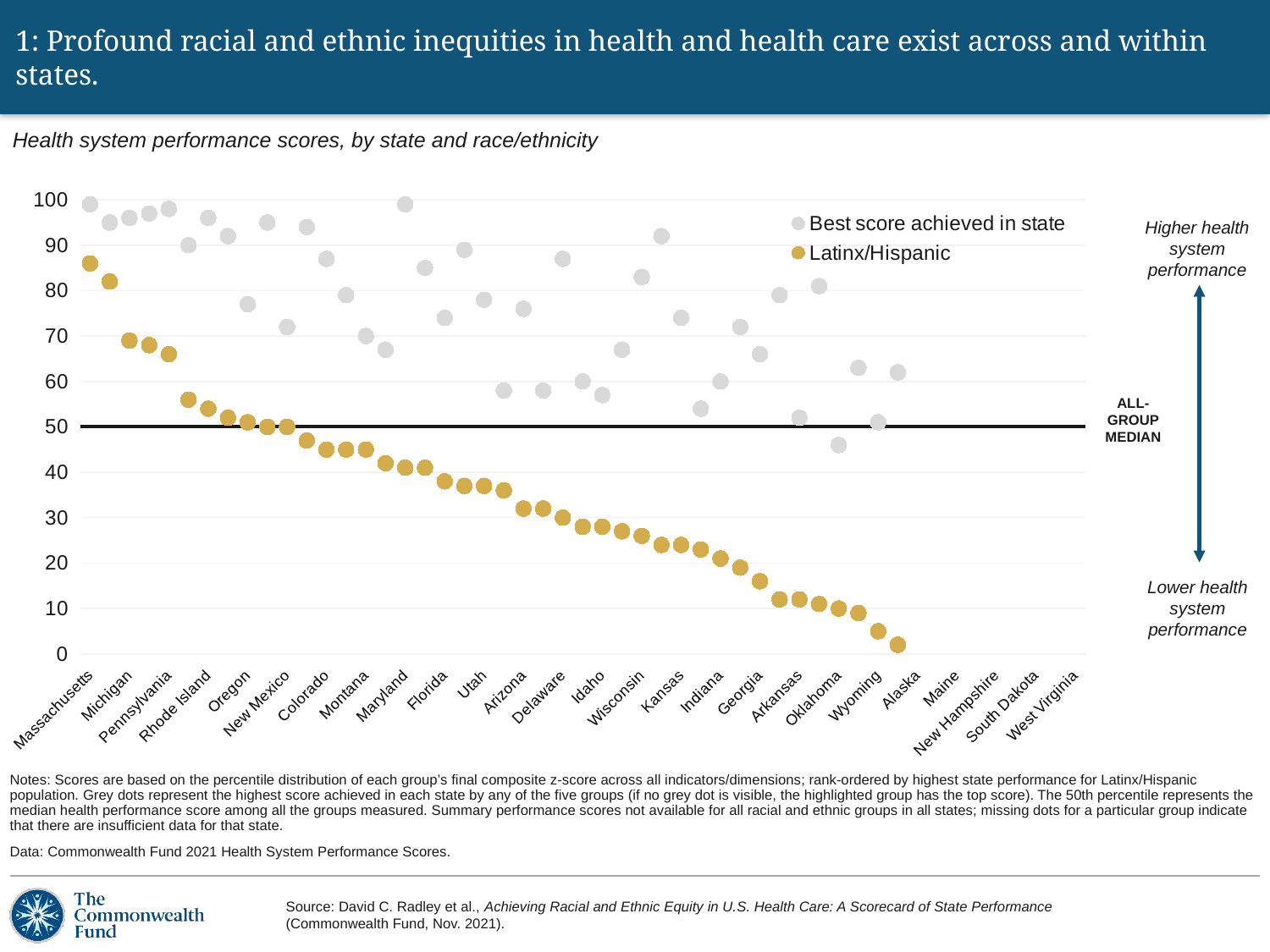
Do the Latinx/Hispanic scores rise or fall moving from left to right along the x axis? fall Which colour represents the 'Best score achieved in state' series in the legend? Grey Which state has the highest Latinx/Hispanic health system performance score? Massachusetts Is the Latinx/Hispanic score for Massachusetts greater or less than 90? less What value does the horizontal 'ALL-GROUP MEDIAN' line sit at on the y axis? 50 What kind of chart is shown on the slide? Scatter (dot) chart Is the Latinx/Hispanic score for Massachusetts greater or less than 80? greater How many series does the chart legend list? 2